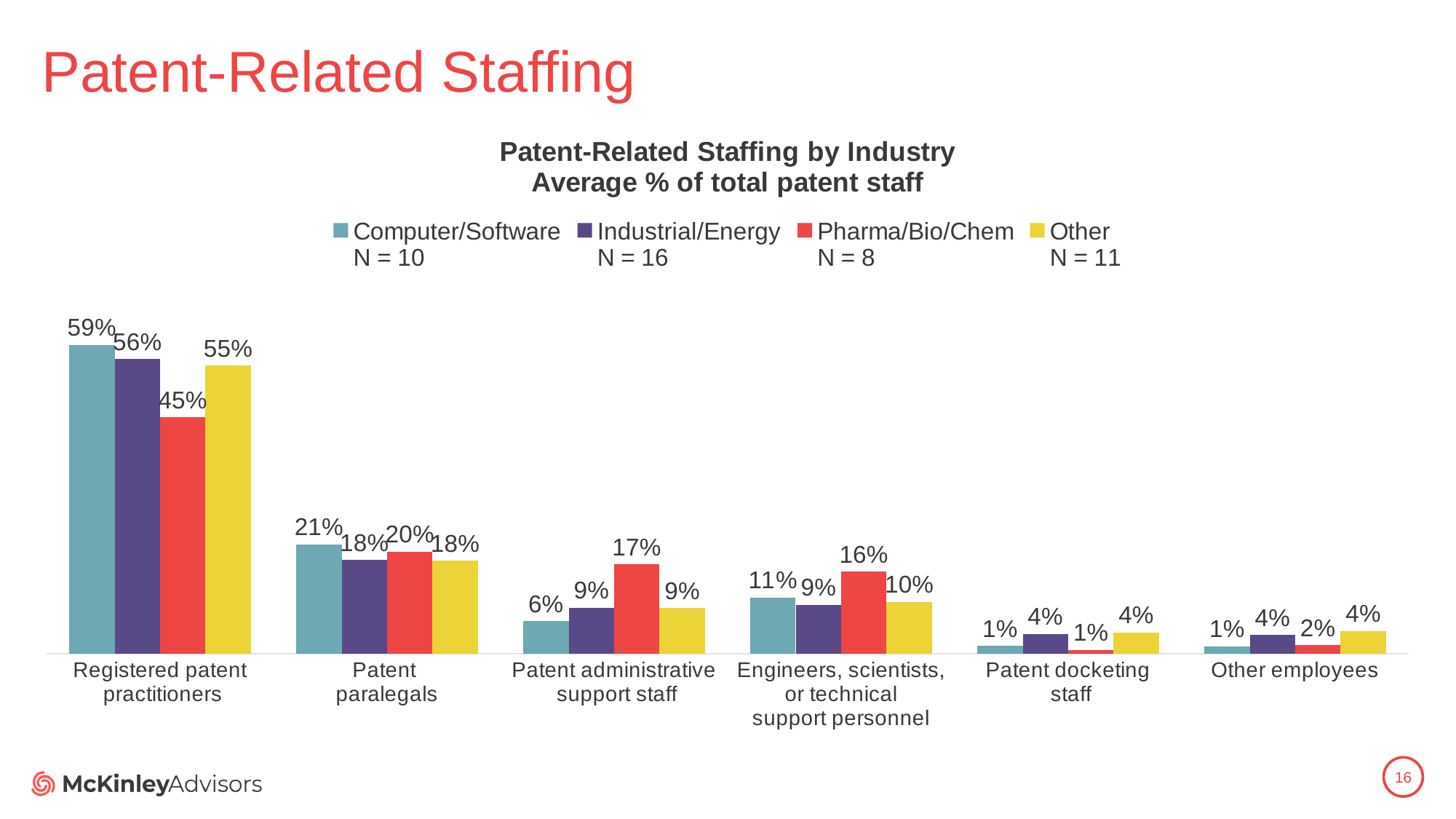
What is the value for Computer/Software in the Registered patent practitioners category? 59% How many series does the legend list? 4 What is the difference between the Computer/Software and Pharma/Bio/Chem values for Registered patent practitioners? 14% Which industry has the highest value for Registered patent practitioners? Computer/Software What is the value for Other in the Engineers, scientists, or technical support personnel category? 10% How many staffing categories are shown on the x axis? 6 What is the value for Pharma/Bio/Chem in the Patent administrative support staff category? 17% What is the title of the chart? Patent-Related Staffing by Industry Average % of total patent staff Which industry has the lowest value for Registered patent practitioners? Pharma/Bio/Chem Which is larger for Patent paralegals: Computer/Software or Industrial/Energy? Computer/Software What kind of chart is shown on the slide? Bar chart What is the sample size (N) for the Industrial/Energy series shown in the legend? N = 16